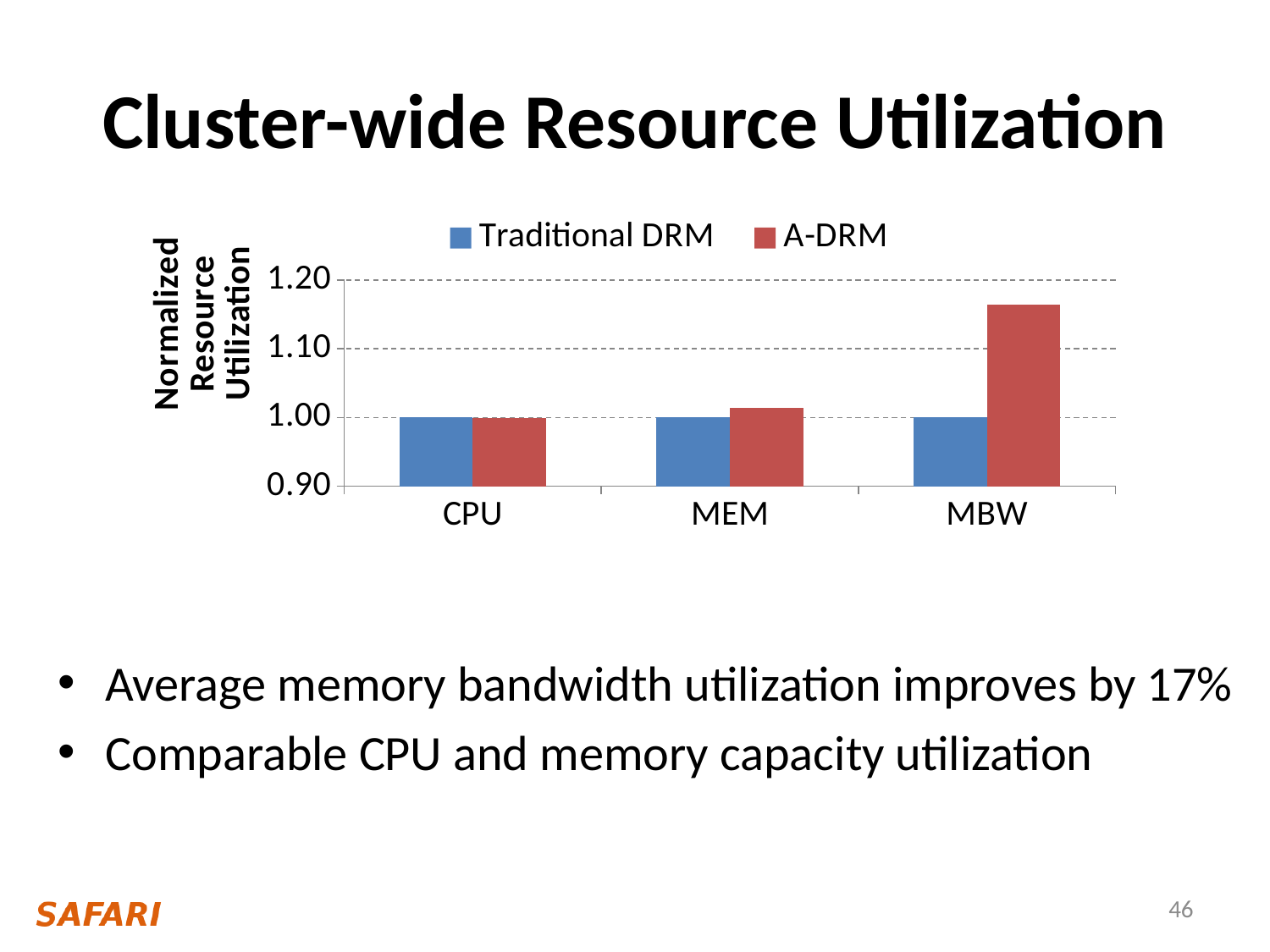
Is the A-DRM value for MBW greater or less than 1.10? greater Is the A-DRM value for MEM greater or less than 1.10? less For which category is the A-DRM value highest? MBW What kind of chart is shown on the slide? bar chart How many categories are shown on the x axis? 3 Which series is shown in red? A-DRM What is the Traditional DRM value for MBW? 1.00 What is the Traditional DRM value for CPU? 1.00 For MBW, which series has the larger value, Traditional DRM or A-DRM? A-DRM What is the label on the y axis? Normalized Resource Utilization How many series does the legend list? 2